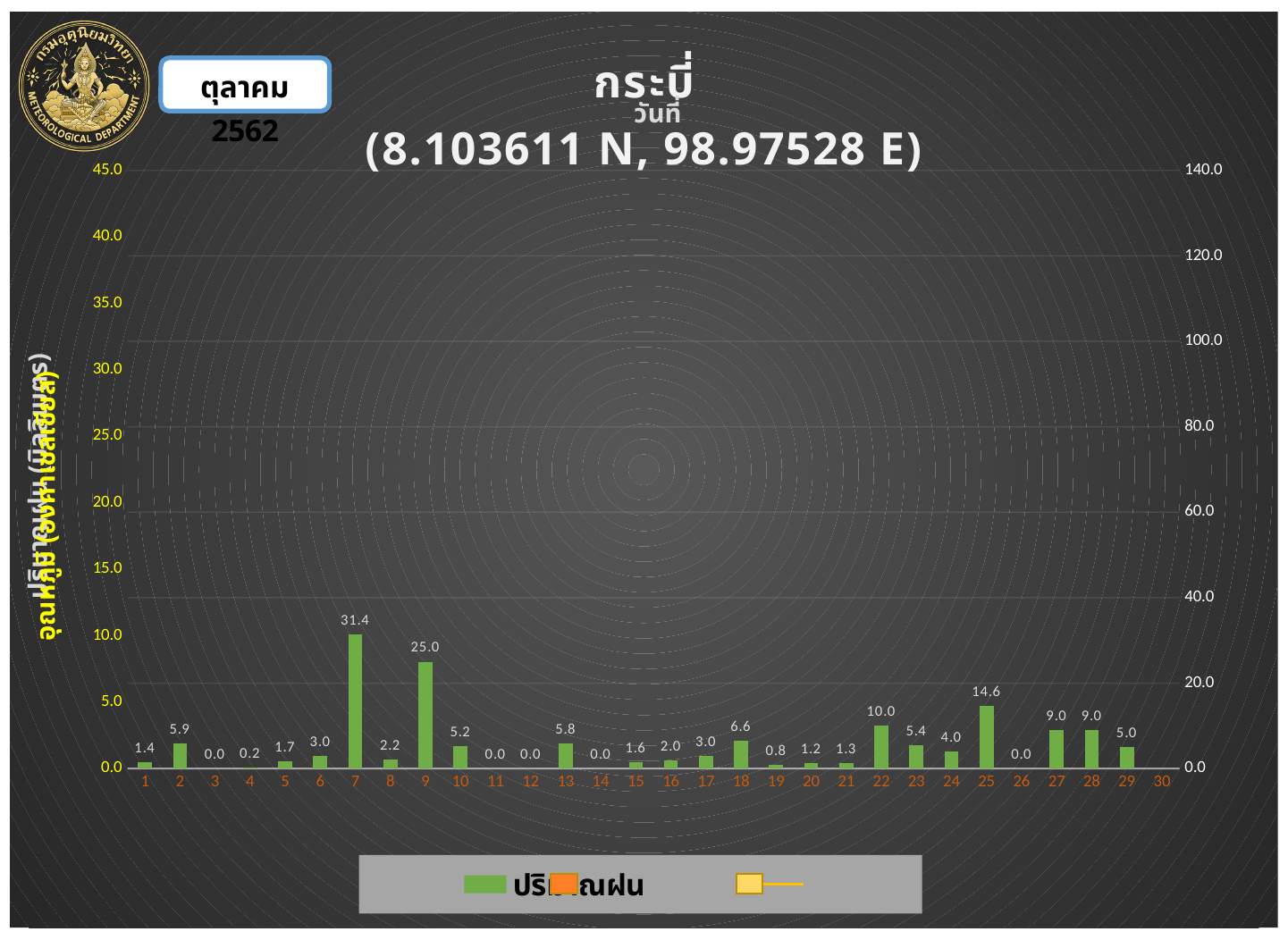
What is the value for day 9? 25.0 What is the difference between the values for day 7 and day 9? 6.4 What is the value for day 18? 6.6 What is the difference between the values for day 18 and day 13? 0.8 Which is larger, the value for day 22 or the value for day 25? day 25 What is the value for day 22? 10.0 Which day has the highest value? 7 Which is larger, the value for day 2 or the value for day 10? day 2 What is the value for day 7? 31.4 How many days are shown on the x axis? 30 What kind of chart is shown on the slide? bar chart What is the value for day 25? 14.6